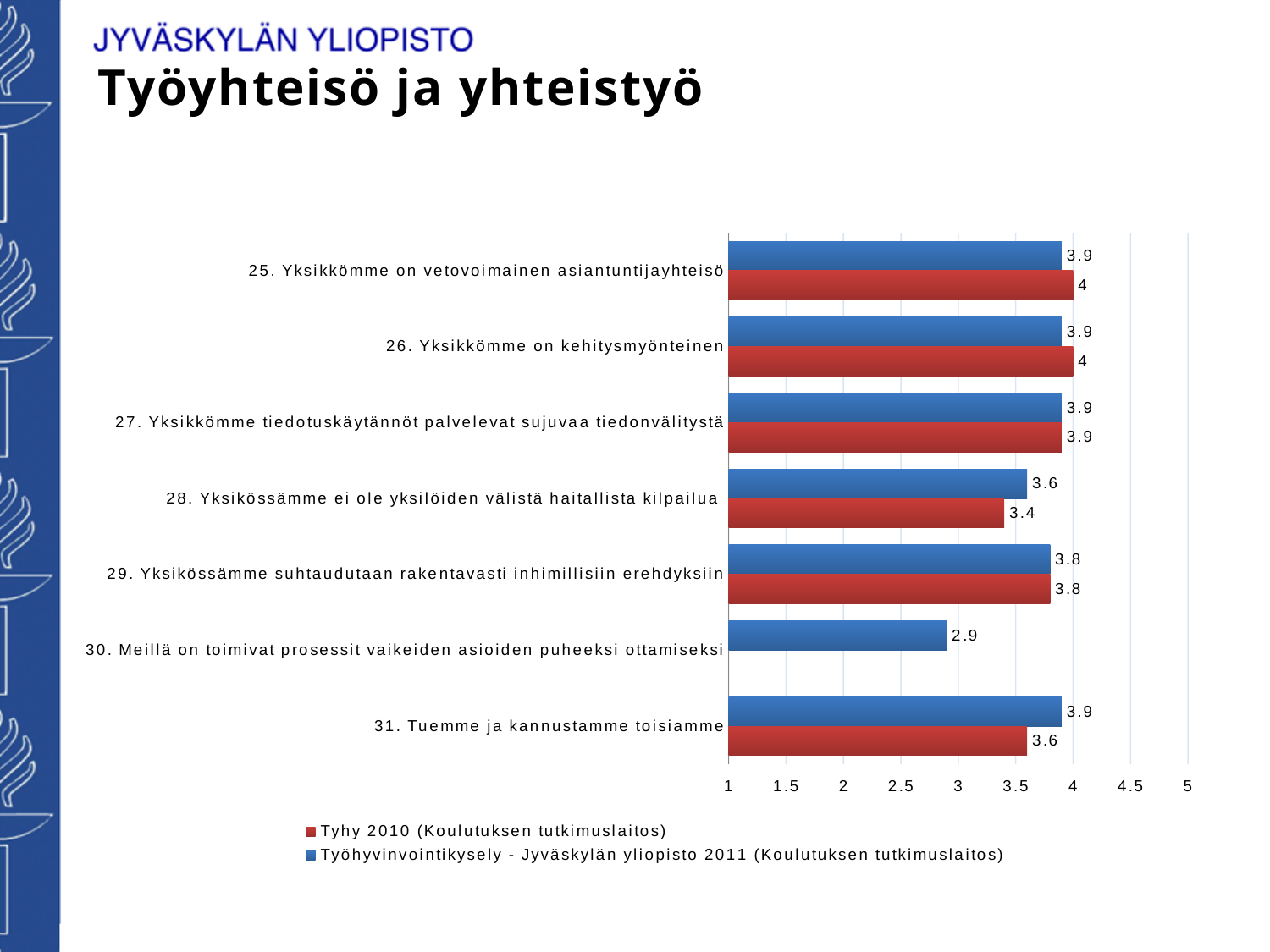
What kind of chart is shown on the slide? bar chart How many categories (statements) are shown on the chart? 7 Which colour represents the Tyhy 2010 series in the chart? red For '28. Yksikössämme ei ole yksilöiden välistä haitallista kilpailua', which series has the larger value, Tyhy 2010 or Työhyvinvointikysely 2011? Työhyvinvointikysely 2011 What is the 2011 (Työhyvinvointikysely) value for '29. Yksikössämme suhtaudutaan rakentavasti inhimillisiin erehdyksiin'? 3.8 What is the Tyhy 2010 value for '28. Yksikössämme ei ole yksilöiden välistä haitallista kilpailua'? 3.4 How many series does the legend list? 2 What is the Tyhy 2010 value for '25. Yksikkömme on vetovoimainen asiantuntijayhteisö'? 4 Which statement has the lowest 2011 (Työhyvinvointikysely) value? 30. Meillä on toimivat prosessit vaikeiden asioiden puheeksi ottamiseksi What is the difference between the 2011 and 2010 values for '31. Tuemme ja kannustamme toisiamme'? 0.3 What is the 2011 (Työhyvinvointikysely) value for '30. Meillä on toimivat prosessit vaikeiden asioiden puheeksi ottamiseksi'? 2.9 Is the 2011 value for '30. Meillä on toimivat prosessit vaikeiden asioiden puheeksi ottamiseksi' greater or less than 3? less